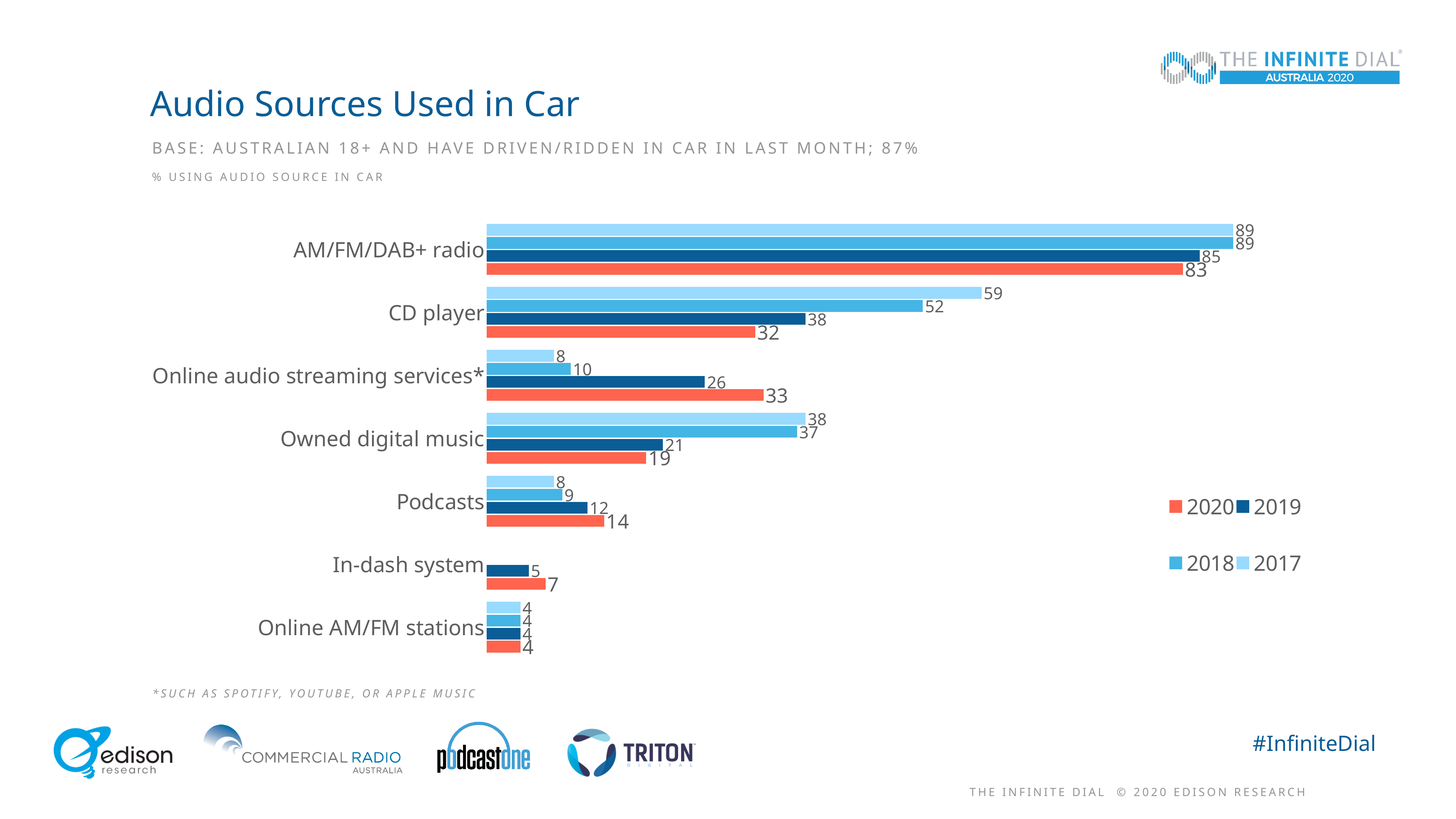
What is the 2017 value for CD player? 59 Which category has the highest 2020 value? AM/FM/DAB+ radio How many categories are shown on the chart? 7 What is the title of the chart? Audio Sources Used in Car What is the difference between the 2017 and 2020 values for CD player? 27 Which is larger for Podcasts: the 2020 value or the 2017 value? 2020 What is the 2020 value for AM/FM/DAB+ radio? 83 What is the 2018 value for Owned digital music? 37 What is the 2019 value for Online audio streaming services*? 26 How many series does the legend list? 4 Which category has the lowest 2020 value? Online AM/FM stations What kind of chart is shown on the slide? Bar chart